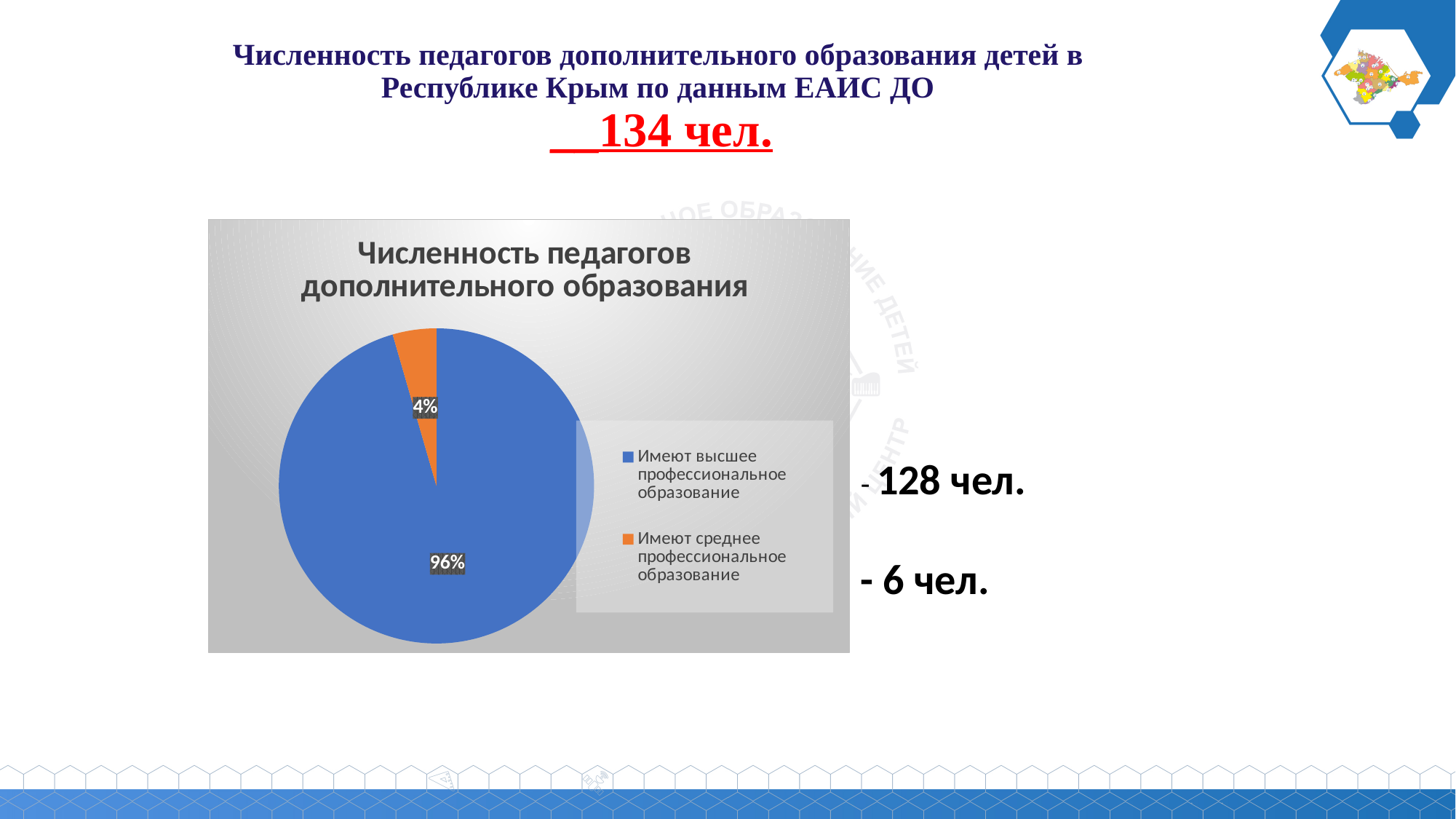
What is the title of the pie chart? Численность педагогов дополнительного образования What colour is the slice for "Имеют среднее профессиональное образование"? orange Is the share for "Имеют высшее профессиональное образование" greater or less than 50%? greater Which category has the largest slice of the pie? Имеют высшее профессиональное образование Which slice is larger: "Имеют высшее профессиональное образование" or "Имеют среднее профессиональное образование"? Имеют высшее профессиональное образование Which category has the smallest slice of the pie? Имеют среднее профессиональное образование How many slices does the pie chart have? 2 What share of the pie is labelled for "Имеют высшее профессиональное образование"? 96% What is the difference in percentage points between the 96% slice and the 4% slice? 92 percentage points What kind of chart is shown on the slide? pie chart What share of the pie is labelled for "Имеют среднее профессиональное образование"? 4% How many entries does the legend list? 2